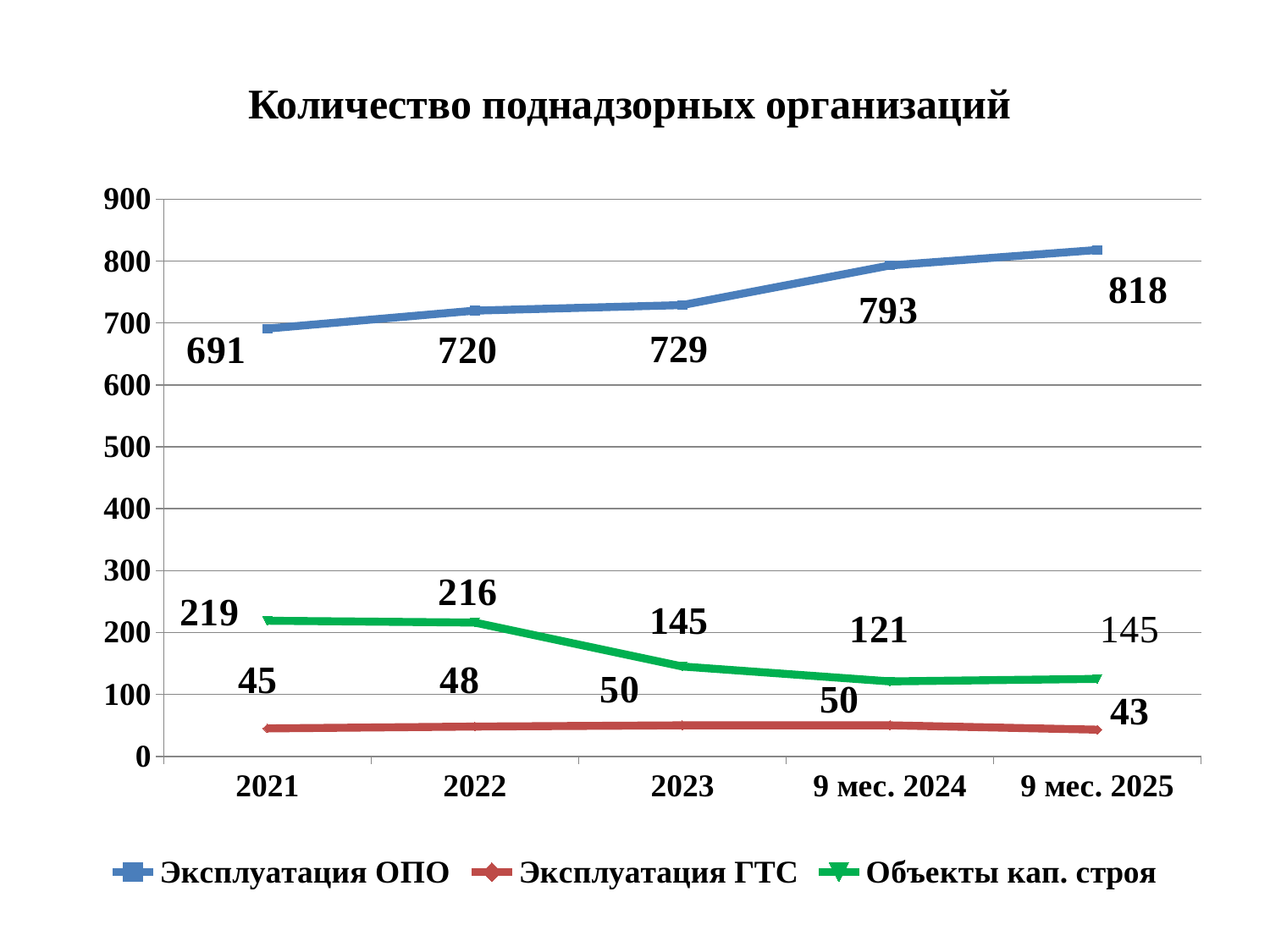
What kind of chart is shown on the slide? line chart Which is larger: the value for Объекты кап. строя in 2023 or in 2022? 2022 What is the value for Эксплуатация ГТС in 9 мес. 2025? 43 In which period is the value for Объекты кап. строя lowest? 9 мес. 2024 What is the value for Эксплуатация ОПО in 2021? 691 Does the value for Эксплуатация ОПО rise or fall from 2021 to 9 мес. 2025? rise In which period is the value for Эксплуатация ОПО highest? 9 мес. 2025 What is the difference between the Эксплуатация ОПО values for 9 мес. 2025 and 2021? 127 How many series does the legend list? 3 How many periods are shown on the x axis? 5 What is the value for Объекты кап. строя in 2022? 216 What is the title of the chart? Количество поднадзорных организаций